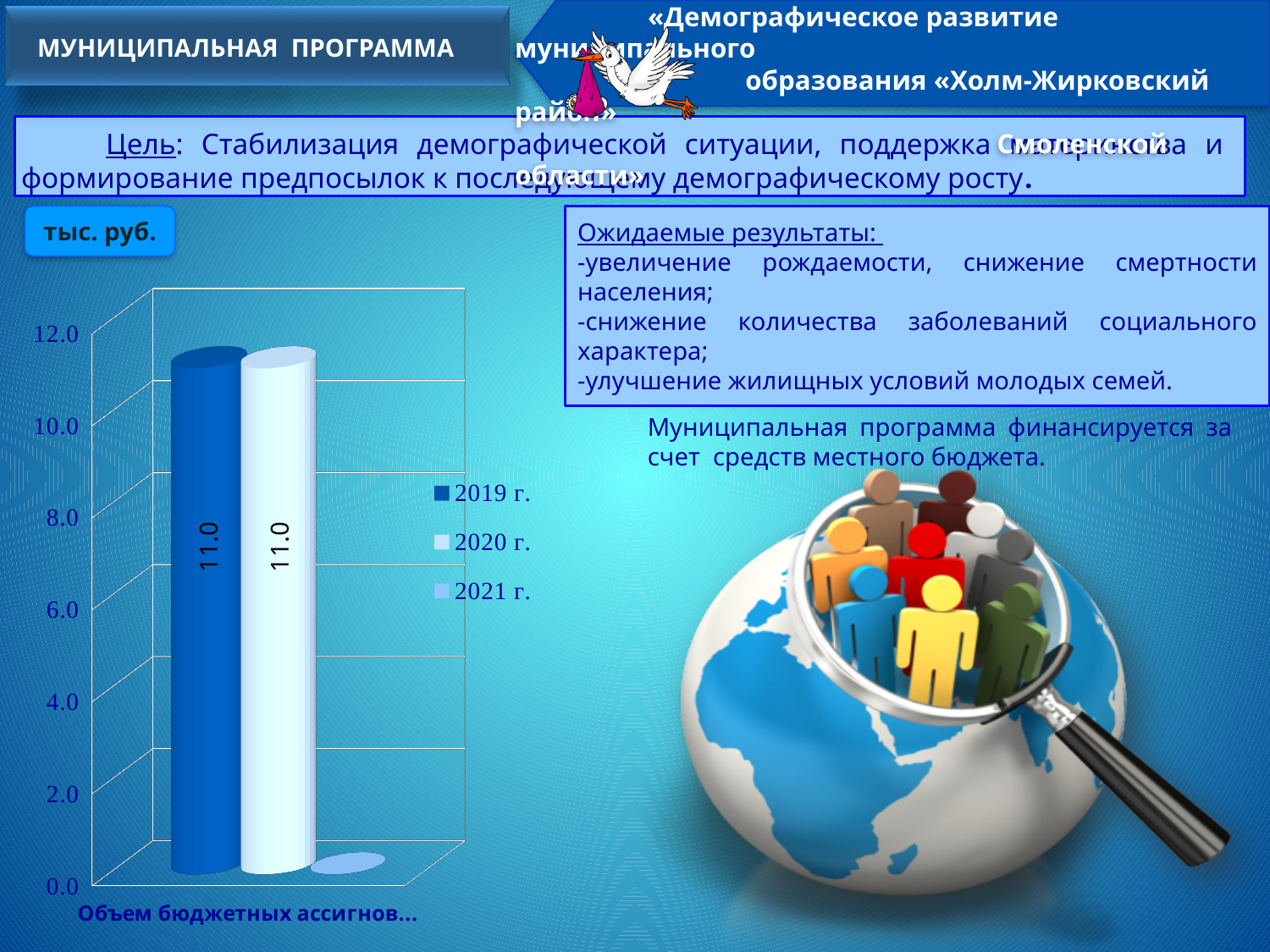
Is the value for 2020 г. greater or less than 8.0? greater What is the difference between the values for 2019 г. and 2020 г.? 0.0 How many series does the chart legend list? 3 What is the value for 2019 г. in the bar chart? 11.0 What is the highest tick value shown on the chart's vertical axis? 12.0 Which series has the lowest value in the chart? 2021 г. How many categories are shown on the x axis of the chart? 1 What unit is indicated for the chart values? тыс. руб. Is the value for 2019 г. greater or less than 10.0? greater What is the value for 2020 г. in the bar chart? 11.0 What kind of chart is shown on the slide? bar chart Is the value for 2021 г. greater or less than 2.0? less